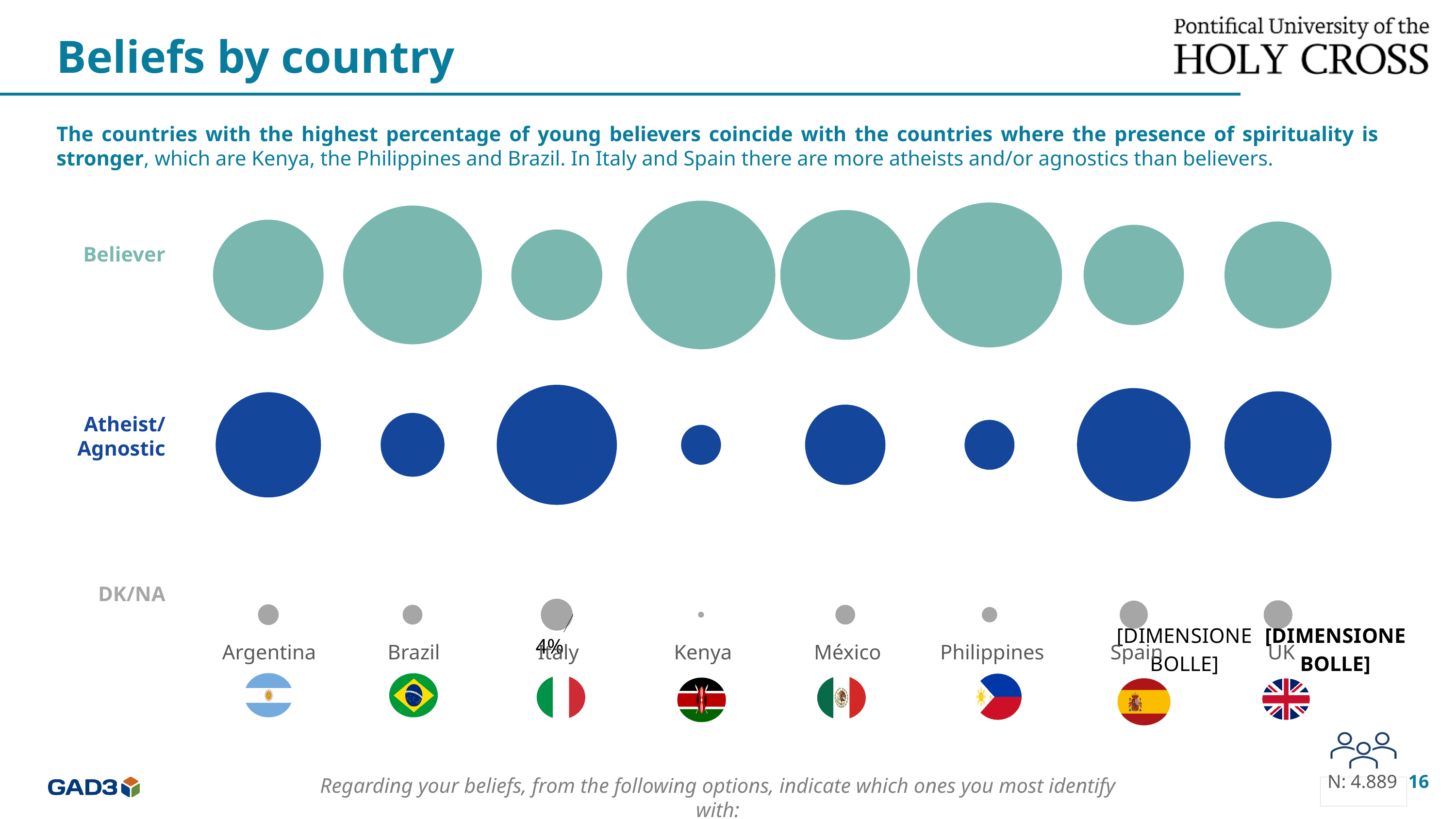
For Italy, which bubble is larger: Believer or Atheist/Agnostic? Atheist/Agnostic Which country has the smallest DK/NA bubble? Kenya For Brazil, which bubble is larger: Believer or Atheist/Agnostic? Believer How many countries are shown along the bottom of the chart? 8 What is the title of the slide's chart? Beliefs by country What sample size (N) is shown on the slide? N: 4.889 Which country has the smallest Believer bubble? Italy Which country has the smallest Atheist/Agnostic bubble? Kenya How many belief categories (rows) does the chart show? 3 What is the DK/NA value printed for Italy? 4% For Kenya, which bubble is larger: Believer or Atheist/Agnostic? Believer What kind of chart is shown on the slide? Bubble chart